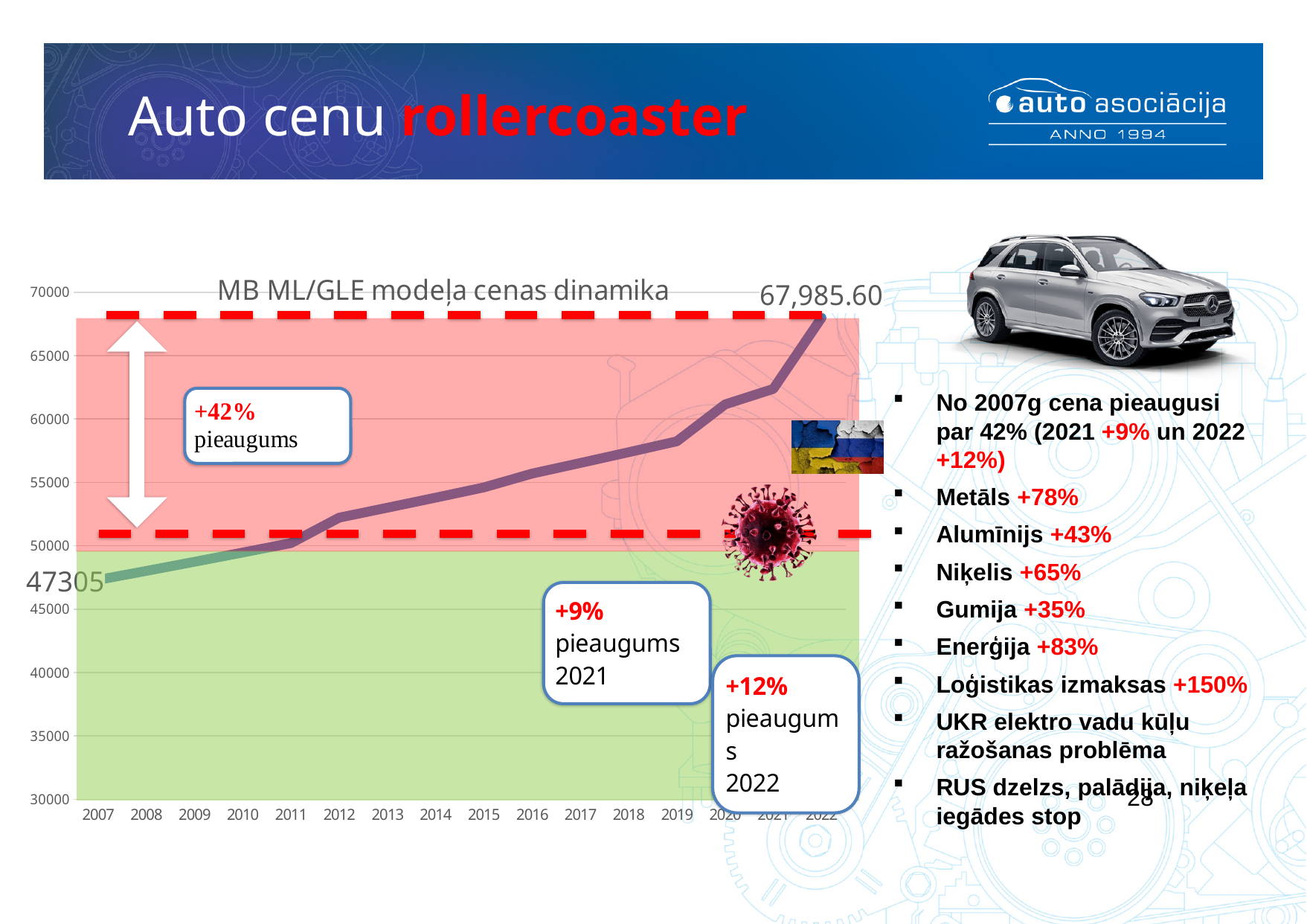
Is the value for 2019 greater or less than 55000? greater What is the difference between the 2022 value and the 2007 value? 20,680.60 What percentage increase does the annotation in the red area of the chart state? +42% Is the value for 2008 greater or less than 50000? less What is the value plotted for 2007? 47305 Which year has the highest value on the chart? 2022 What is the value plotted for 2022? 67,985.60 What is the title of the chart? MB ML/GLE modeļa cenas dinamika How many years are shown on the x axis of the chart? 16 Which year has the lowest value on the chart? 2007 What kind of chart is shown on the slide? line chart Do the values rise or fall from 2007 to 2022? rise